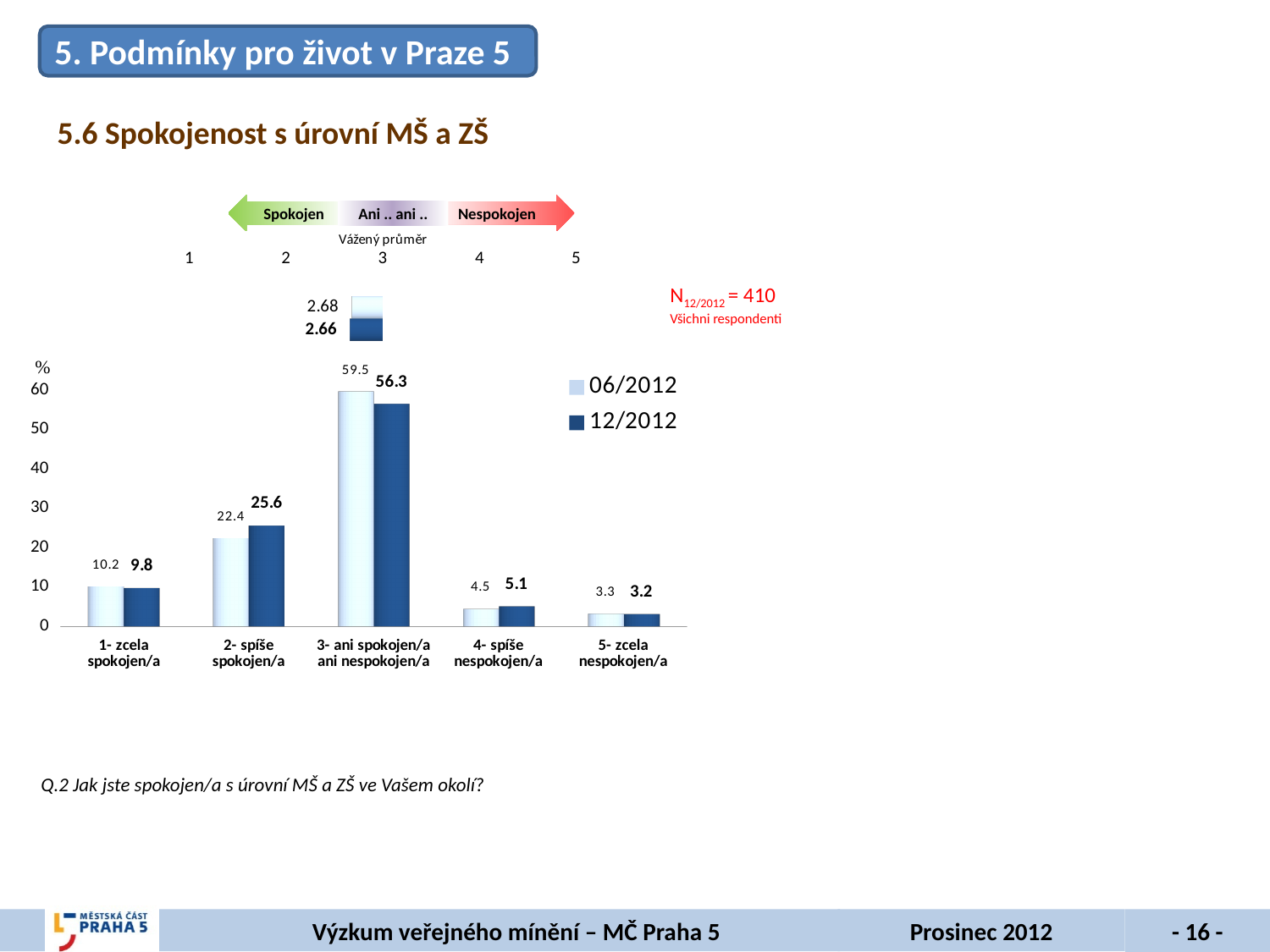
In the main bar chart, what is the 06/2012 value for '2- spíše spokojen/a'? 22.4 In the main bar chart, what is the 12/2012 value for '5- zcela nespokojen/a'? 3.2 In the main bar chart, is the 12/2012 value for '3- ani spokojen/a ani nespokojen/a' greater or less than 50? greater In the main bar chart, what is the 12/2012 value for '3- ani spokojen/a ani nespokojen/a'? 56.3 How many series does the legend of the main bar chart list? 2 In the main bar chart, which category has the lowest 06/2012 value? 5- zcela nespokojen/a In the main bar chart, which is larger for '1- zcela spokojen/a': the 06/2012 value or the 12/2012 value? 06/2012 What kind of chart is the main chart on the slide? bar chart How many categories are shown on the x axis of the main bar chart? 5 In the 'Vážený průměr' chart, what is the weighted average for 12/2012? 2.66 In the main bar chart, what is the difference between the 06/2012 and 12/2012 values for '2- spíše spokojen/a'? 3.2 In the main bar chart, which category has the highest 12/2012 value? 3- ani spokojen/a ani nespokojen/a